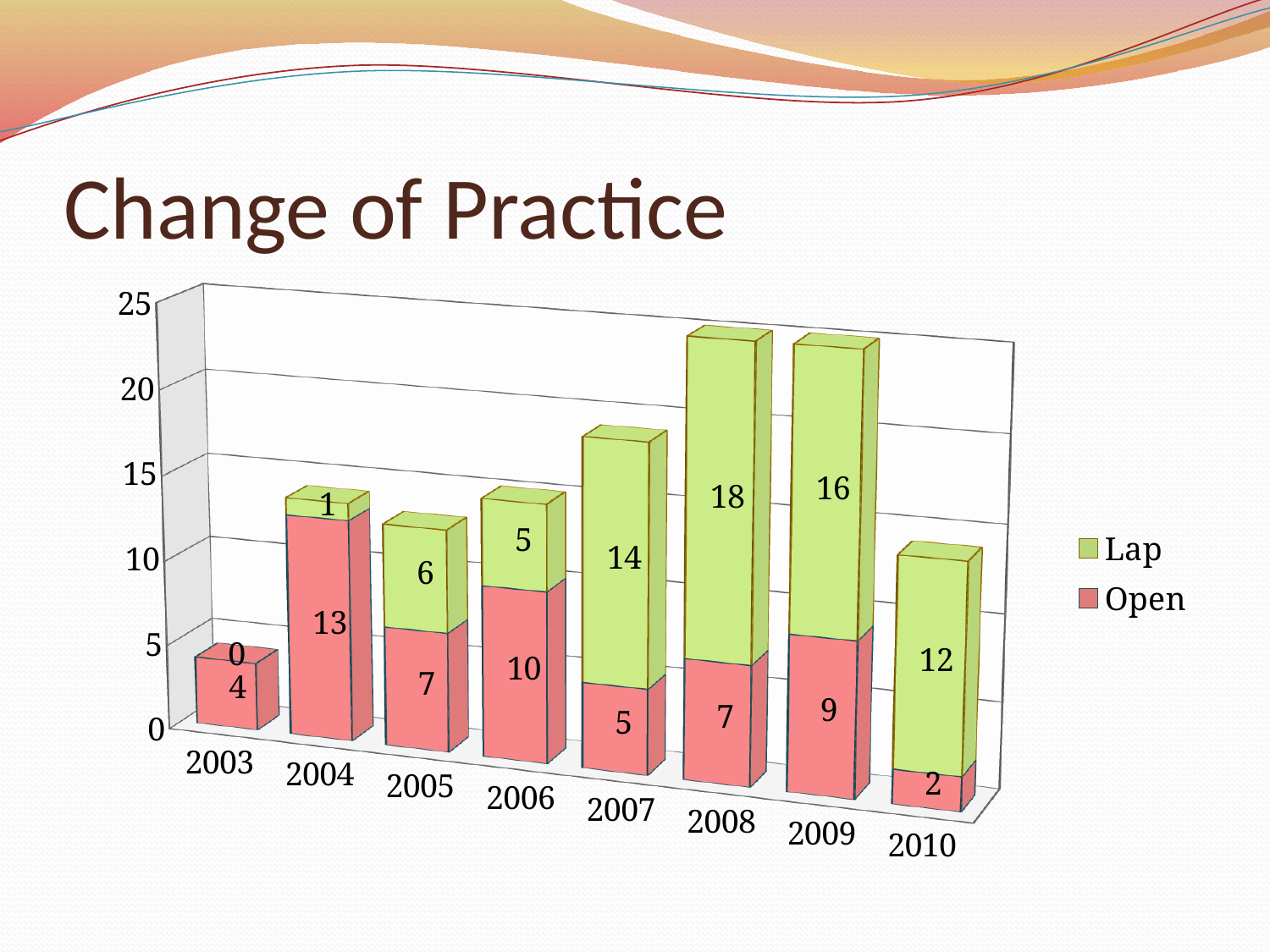
What is the difference between the Lap value and the Open value in 2010? 10 Which year has the lowest Open value? 2010 How many years are shown on the x axis? 8 What is the total of the stacked bar for 2009? 25 What is the Open value for 2004? 13 Which year has the highest Lap value? 2008 Which is larger in 2007, the Lap value or the Open value? Lap What is the total of the stacked bar for 2005? 13 What is the Lap value for 2008? 18 How many series does the legend list? 2 What is the Lap value for 2003? 0 What kind of chart is shown on the slide? Stacked bar chart